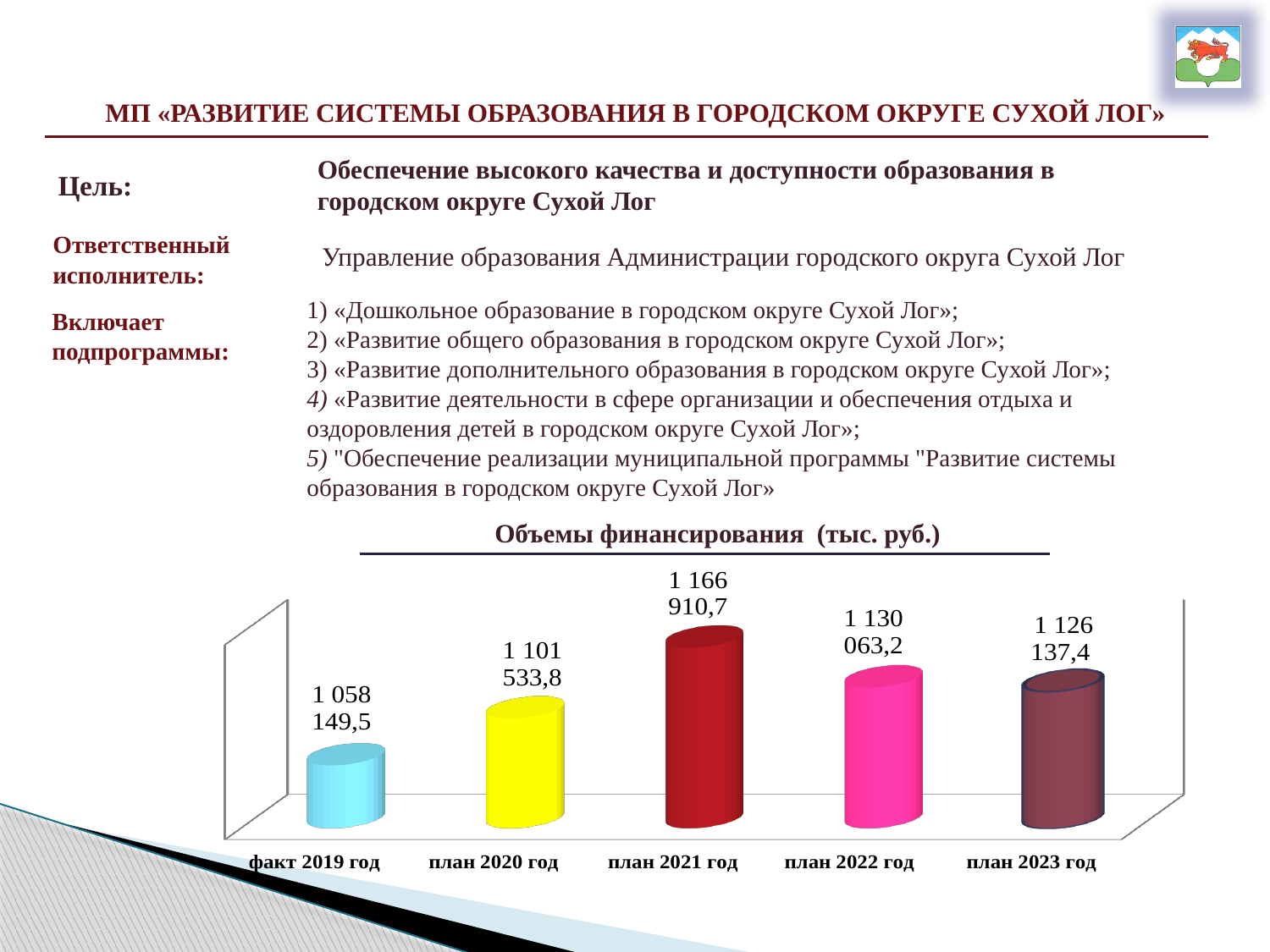
Which is larger in the chart «Объемы финансирования (тыс. руб.)»: the value for план 2022 год or план 2023 год? план 2022 год What is the value for план 2021 год in the chart «Объемы финансирования (тыс. руб.)»? 1 166 910,7 What is the difference between the values for план 2021 год and факт 2019 год in the chart «Объемы финансирования (тыс. руб.)»? 108 761,2 What is the value for факт 2019 год in the chart «Объемы финансирования (тыс. руб.)»? 1 058 149,5 Which category has the highest value in the chart «Объемы финансирования (тыс. руб.)»? план 2021 год Which category has the lowest value in the chart «Объемы финансирования (тыс. руб.)»? факт 2019 год What kind of chart is «Объемы финансирования (тыс. руб.)»? bar chart What is the difference between the values for план 2022 год and план 2023 год in the chart «Объемы финансирования (тыс. руб.)»? 3 925,8 What is the value for план 2023 год in the chart «Объемы финансирования (тыс. руб.)»? 1 126 137,4 How many categories are shown in the chart «Объемы финансирования (тыс. руб.)»? 5 In the chart «Объемы финансирования (тыс. руб.)», do the values rise or fall from факт 2019 год to план 2021 год? rise What is the value for план 2020 год in the chart «Объемы финансирования (тыс. руб.)»? 1 101 533,8